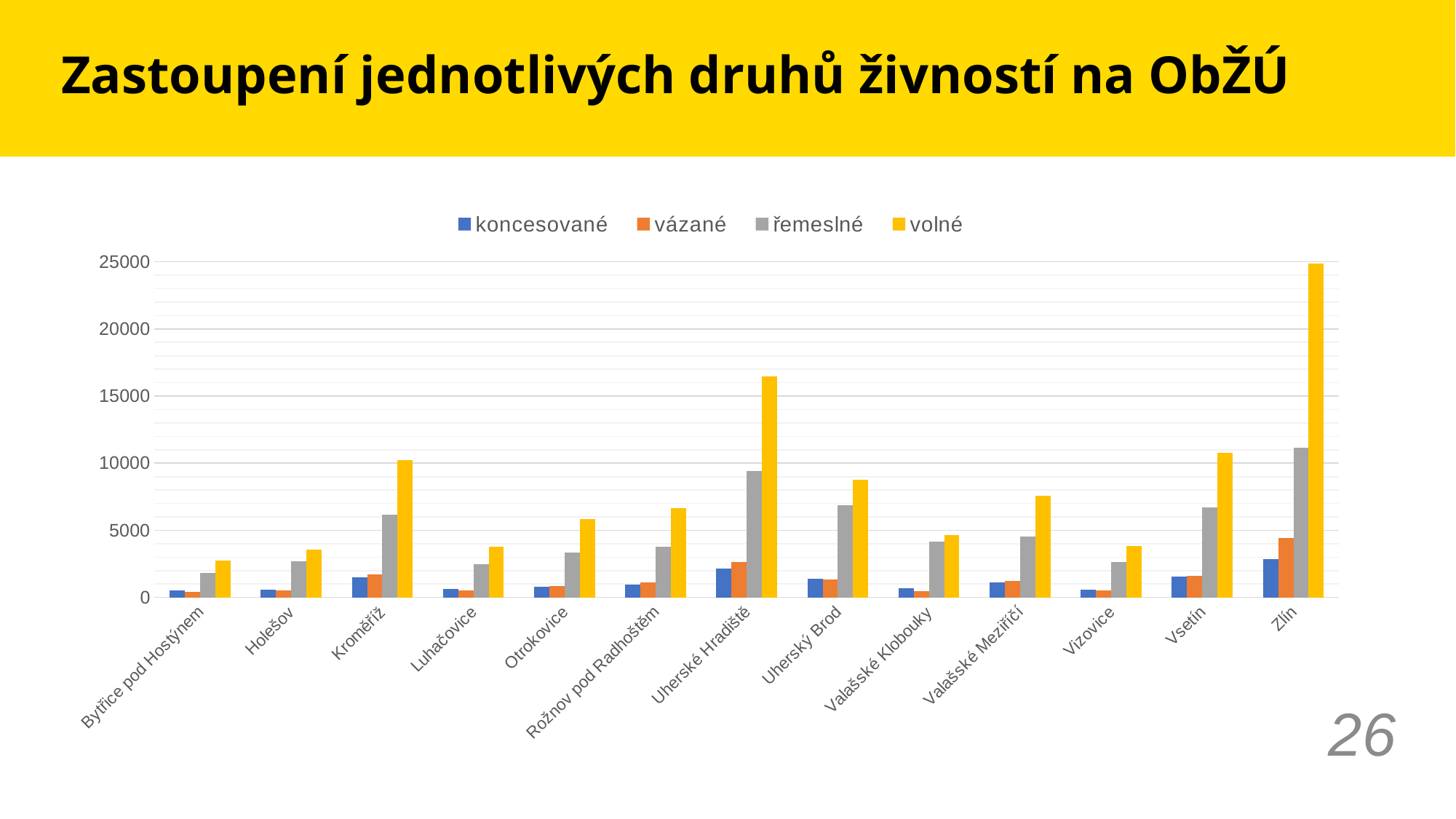
Which is larger, the volné value for Uherské Hradiště or for Vsetín? Uherské Hradiště How many series does the legend list? 4 Which category has the lowest value for volné? Bytřice pod Hostýnem How many categories (municipalities) are shown on the x axis? 13 Is the value for volné in Valašské Meziříčí greater or less than 5000? greater Is the value for volné in Uherské Hradiště greater or less than 15000? greater Is the value for volné in Uherský Brod greater or less than 10000? less Which colour represents the volné series in the legend? yellow Which category has the highest value for volné? Zlín What kind of chart is shown on the slide? bar chart Which category has the highest value for řemeslné? Zlín